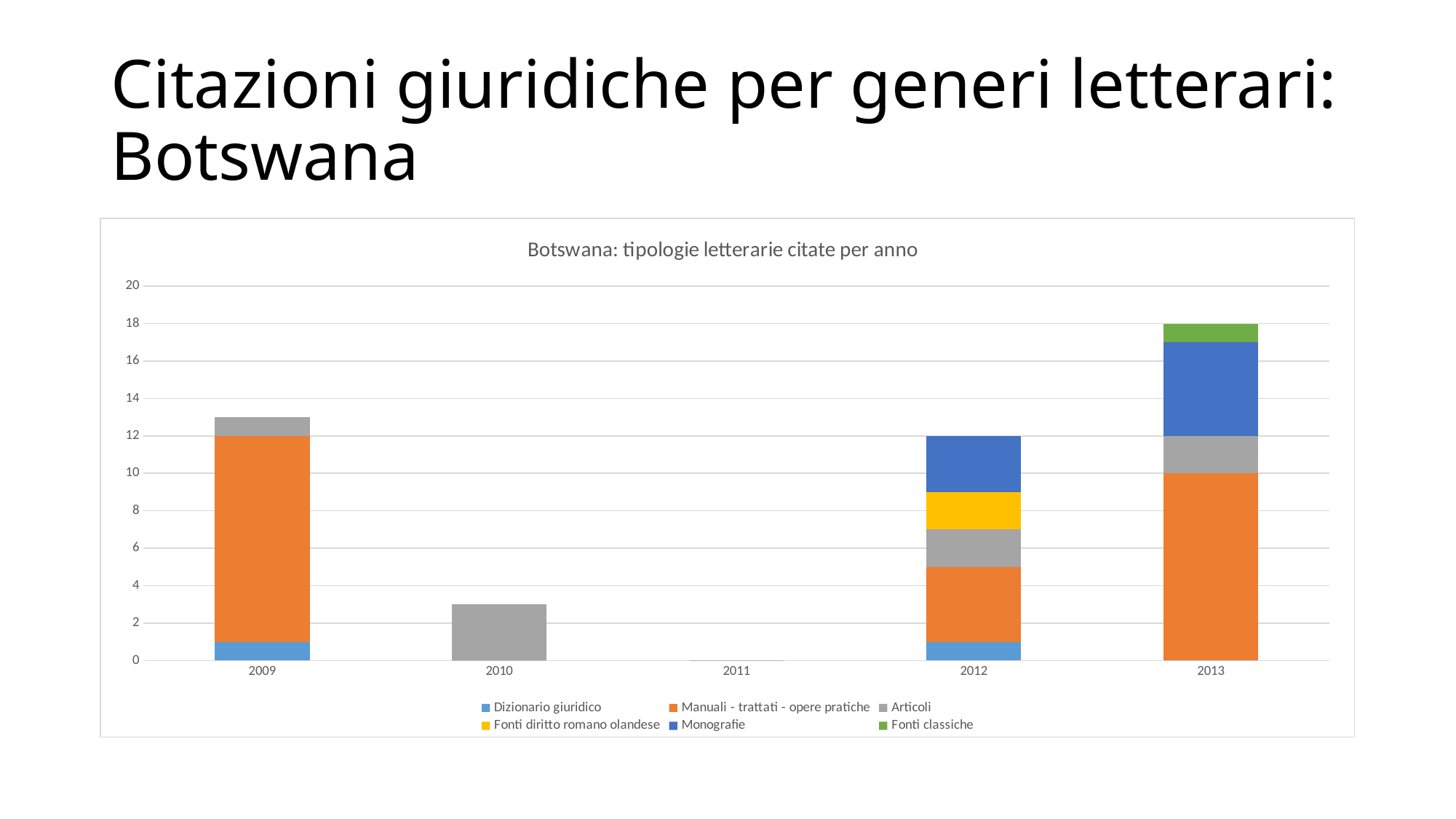
What kind of chart is shown on the slide? Stacked bar chart Is the total for 2009 greater or less than 12? greater How many years are shown on the x axis? 5 What is the value of 'Manuali - trattati - opere pratiche' in 2013? 10 Is the total for 2010 greater or less than 4? less What is the total height of the stacked bar for 2012? 12 Which year has the highest total number of citations? 2013 What is the total height of the stacked bar for 2013? 18 How many series does the legend list? 6 Which year has a larger total, 2010 or 2013? 2013 What is the title of the chart? Botswana: tipologie letterarie citate per anno Which year has the lowest total number of citations? 2011